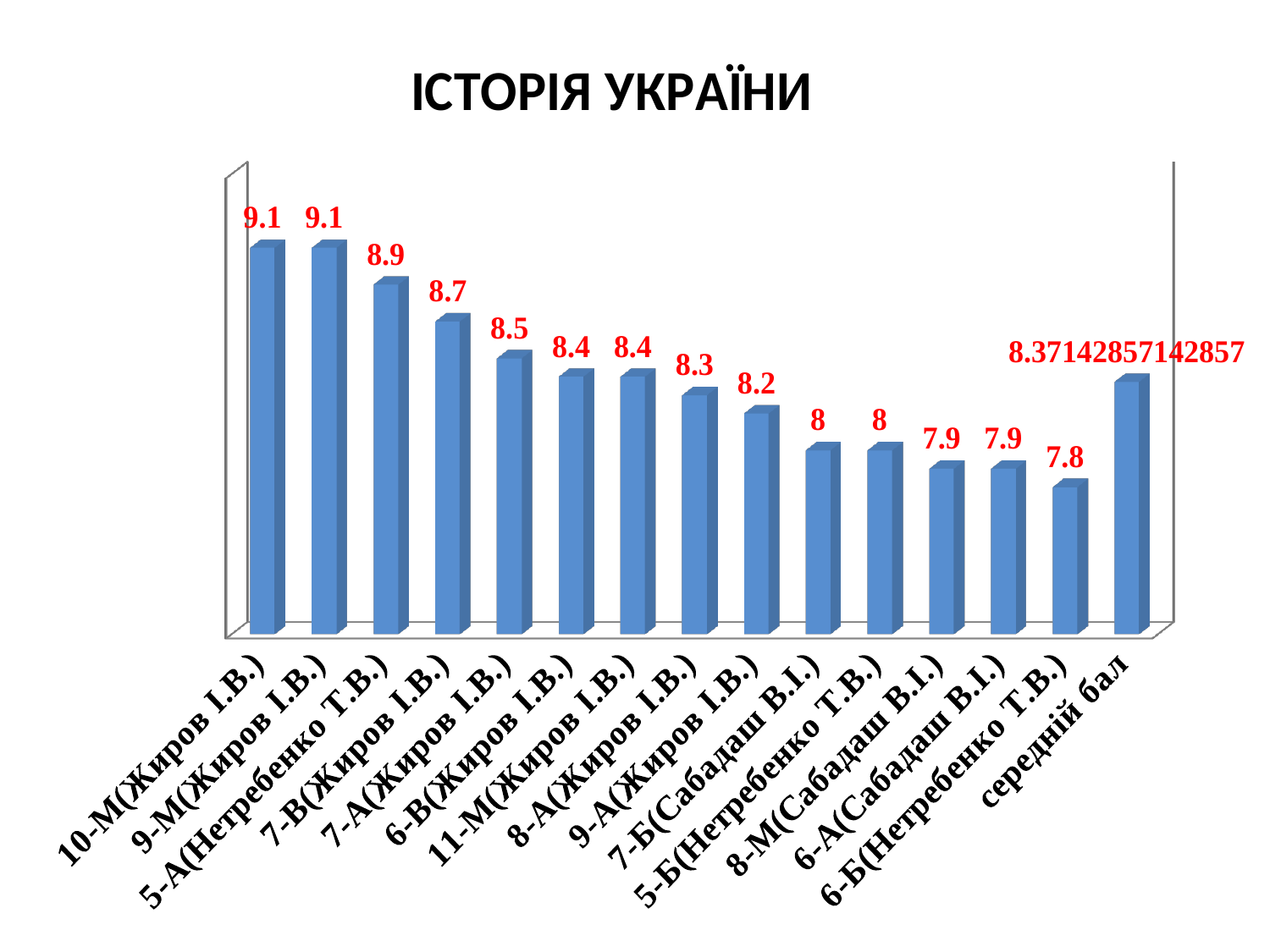
Which is larger, the value for 7-А(Жиров І.В.) or the value for 8-А(Жиров І.В.)? 7-А(Жиров І.В.) What is the title of the chart? ІСТОРІЯ УКРАЇНИ What type of chart is shown on the slide? bar chart What is the highest value shown on the chart? 9.1 What is the difference between the values for 5-А(Нетребенко Т.В.) and 5-Б(Нетребенко Т.В.)? 0.9 How many categories are shown on the chart? 15 What is the value for 5-А(Нетребенко Т.В.)? 8.9 What is the difference between the values for 10-М(Жиров І.В.) and 6-Б(Нетребенко Т.В.)? 1.3 What is the value for 9-А(Жиров І.В.)? 8.2 What is the value for 7-В(Жиров І.В.)? 8.7 Which category has the lowest value? 6-Б(Нетребенко Т.В.) What is the value for середній бал? 8.37142857142857